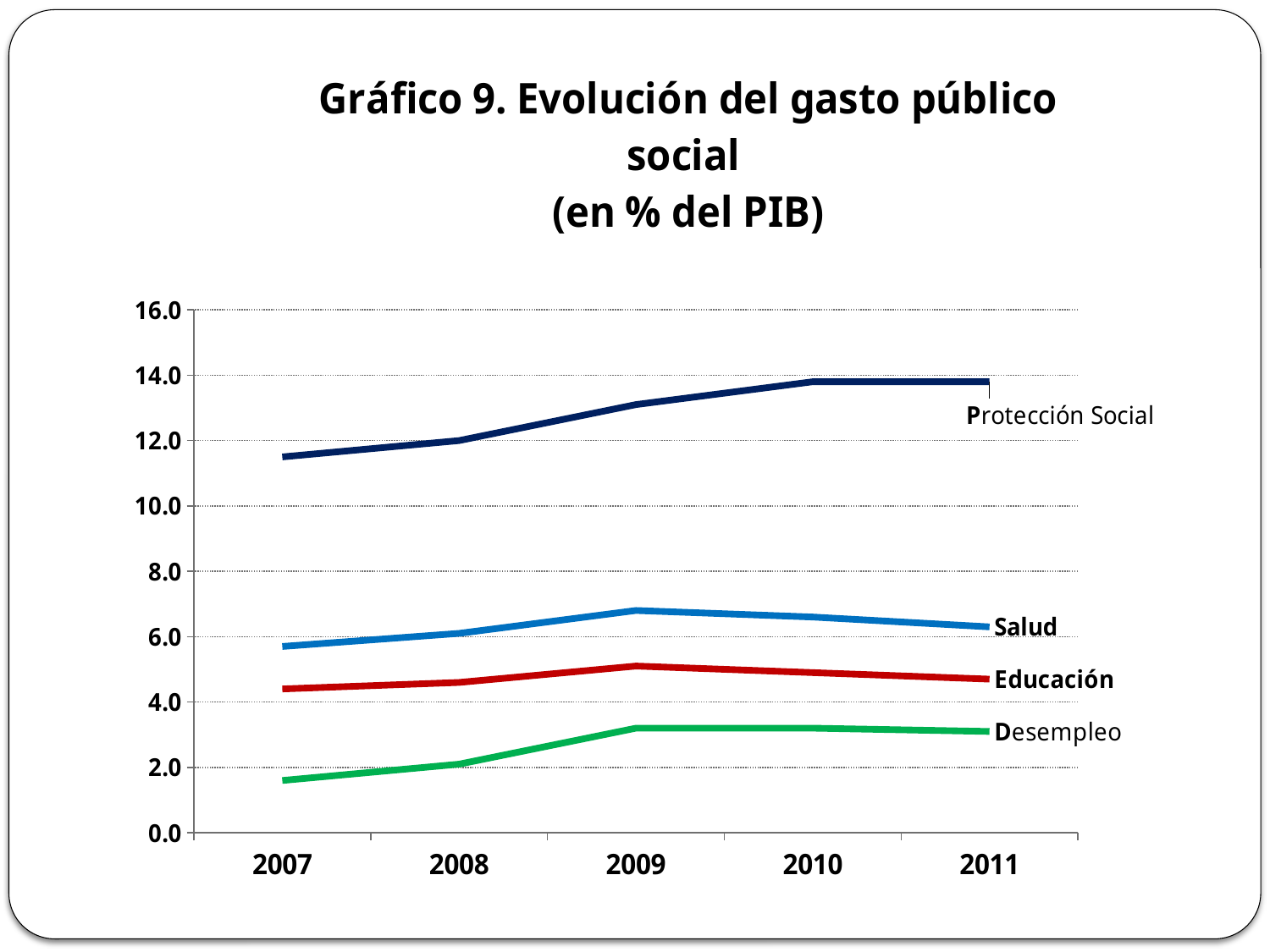
How many series are labelled on the chart? 4 Is the value for Educación in 2009 greater or less than 4.0? greater What type of chart is shown on the slide? line chart Does the Protección Social line rise or fall from 2007 to 2010? rise Is the value for Protección Social in 2007 greater or less than 12.0? less Is the value for Desempleo in 2007 greater or less than 2.0? less In 2011, which is larger, Salud or Educación? Salud Which series has the lowest values across all years? Desempleo How many years are plotted along the x axis? 5 Which series has the highest values across all years? Protección Social